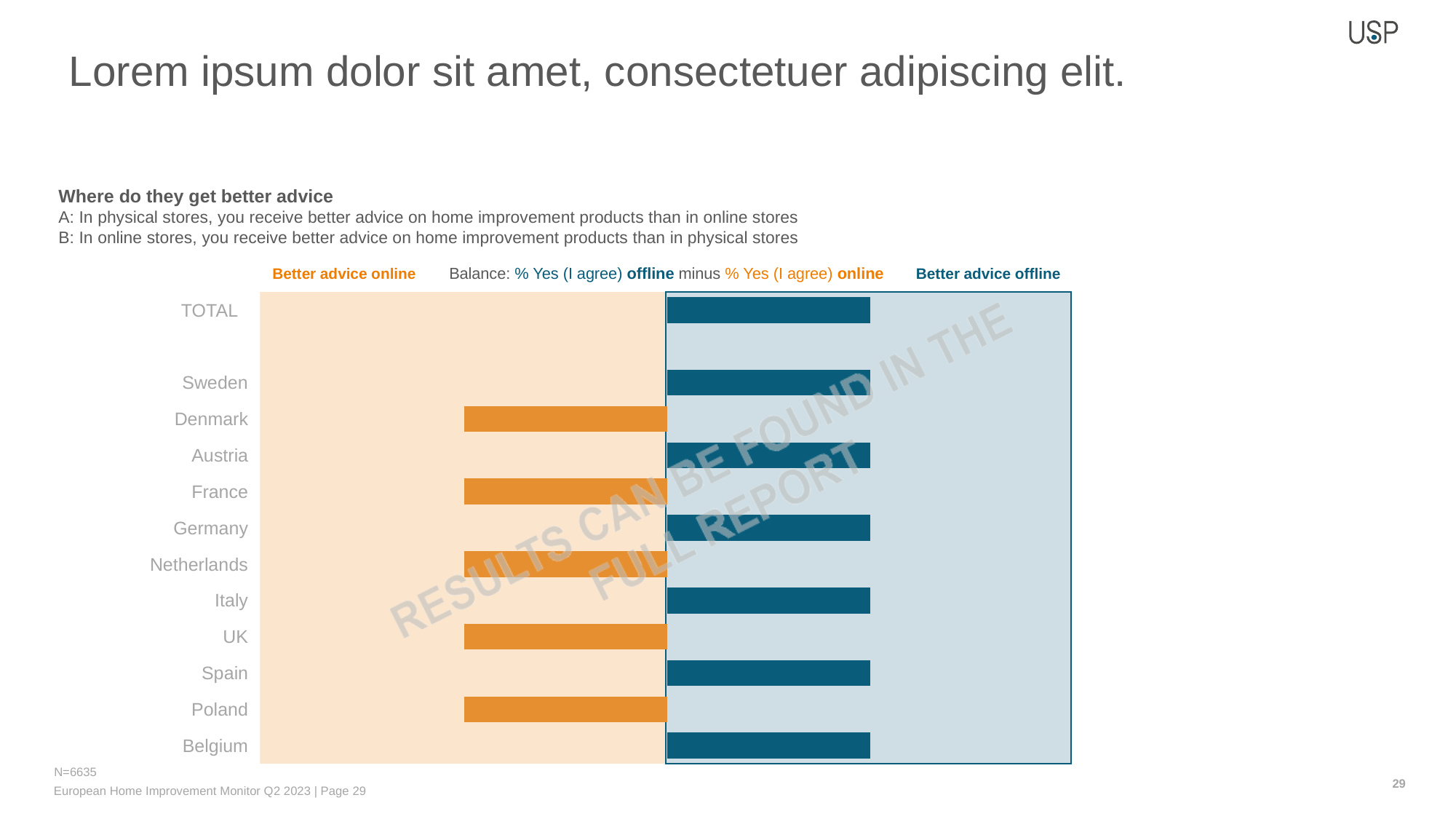
Does the bar for Germany fall on the 'Better advice online' side or the 'Better advice offline' side? Better advice offline Does the bar for Denmark fall on the 'Better advice online' side or the 'Better advice offline' side? Better advice online What is the heading above the chart? Where do they get better advice What colour are the bars on the 'Better advice offline' side of the chart? dark blue How many rows, including TOTAL, have a bar on the 'Better advice offline' side? 7 How many countries are listed in the chart, excluding TOTAL? 11 Does the bar for TOTAL point towards better advice online or better advice offline? Better advice offline Which country is listed first below TOTAL in the chart? Sweden How many countries have a bar on the 'Better advice online' side? 5 What kind of chart is shown on the slide? bar chart Does the bar for Poland point towards better advice online or better advice offline? Better advice online